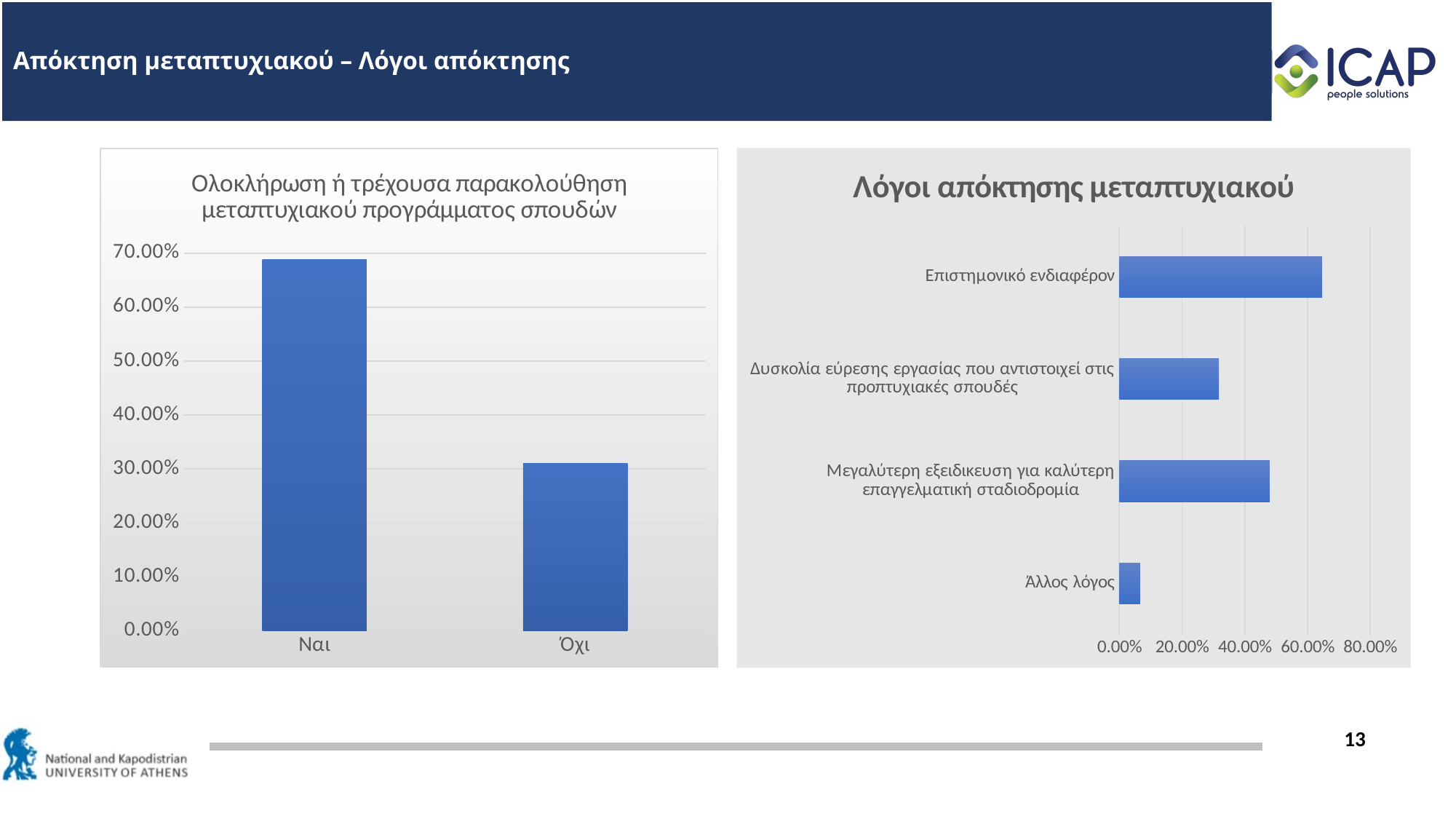
In the right chart (Λόγοι απόκτησης μεταπτυχιακού), which reason has the lowest value? Άλλος λόγος In the left chart (Ολοκλήρωση ή τρέχουσα παρακολούθηση μεταπτυχιακού προγράμματος σπουδών), which category has the higher value? Ναι In the left chart (Ολοκλήρωση ή τρέχουσα παρακολούθηση μεταπτυχιακού προγράμματος σπουδών), what kind of chart is shown? Bar chart In the left chart (Ολοκλήρωση ή τρέχουσα παρακολούθηση μεταπτυχιακού προγράμματος σπουδών), do the values rise or fall from Ναι to Όχι? fall In the right chart (Λόγοι απόκτησης μεταπτυχιακού), which reason has the highest value? Επιστημονικό ενδιαφέρον In the left chart (Ολοκλήρωση ή τρέχουσα παρακολούθηση μεταπτυχιακού προγράμματος σπουδών), is the value for Όχι greater or less than 40.00%? less In the left chart (Ολοκλήρωση ή τρέχουσα παρακολούθηση μεταπτυχιακού προγράμματος σπουδών), how many categories are shown on the x axis? 2 In the left chart (Ολοκλήρωση ή τρέχουσα παρακολούθηση μεταπτυχιακού προγράμματος σπουδών), is the value for Ναι greater or less than 60.00%? greater In the right chart (Λόγοι απόκτησης μεταπτυχιακού), is the value for Άλλος λόγος greater or less than 20.00%? less In the right chart (Λόγοι απόκτησης μεταπτυχιακού), how many reasons (categories) are listed? 4 In the right chart (Λόγοι απόκτησης μεταπτυχιακού), which is larger: the value for Μεγαλύτερη εξειδίκευση για καλύτερη επαγγελματική σταδιοδρομία or the value for Δυσκολία εύρεσης εργασίας που αντιστοιχεί στις προπτυχιακές σπουδές? Μεγαλύτερη εξειδίκευση για καλύτερη επαγγελματική σταδιοδρομία